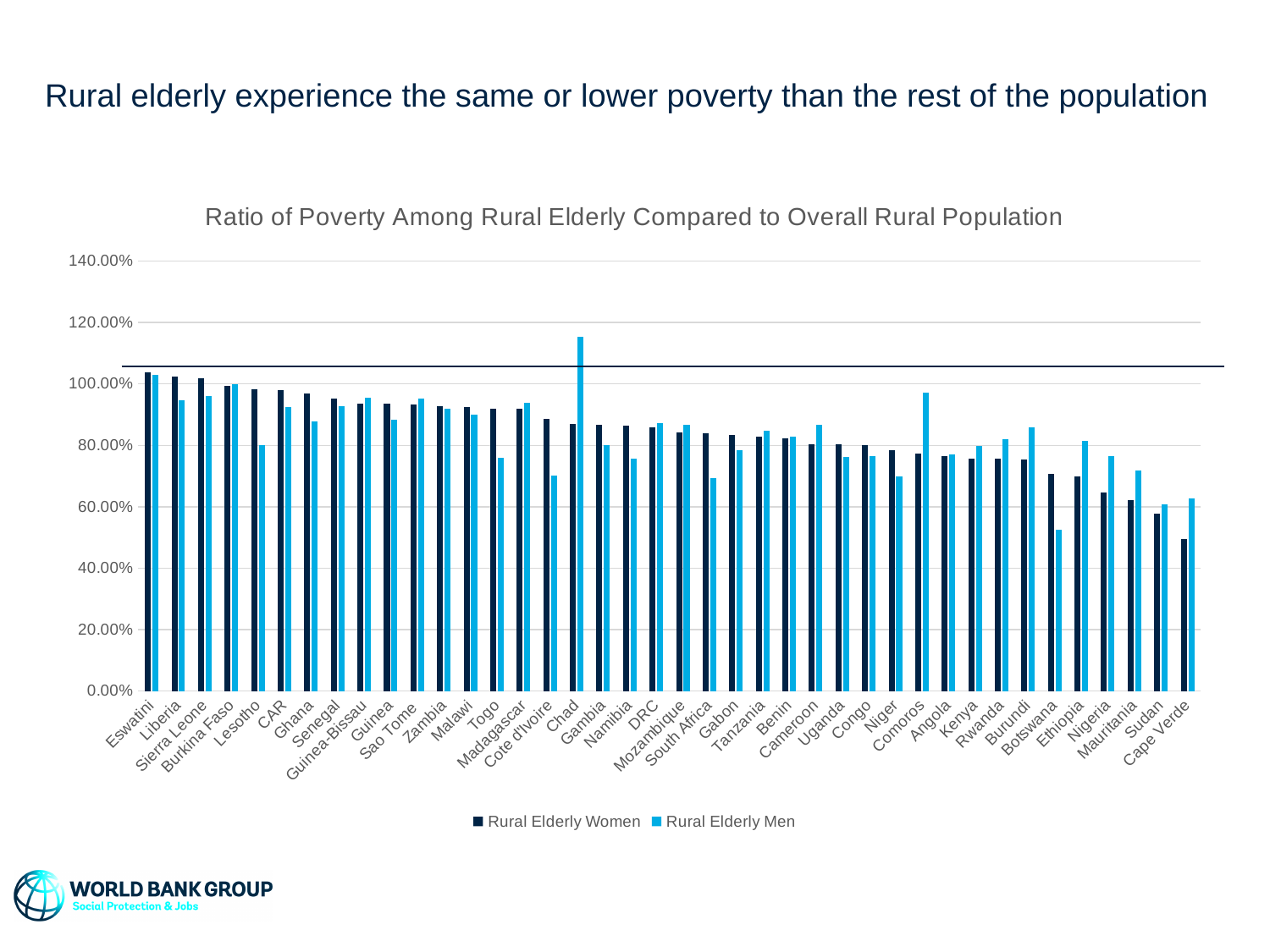
For Comoros, which series has the larger value, Rural Elderly Women or Rural Elderly Men? Rural Elderly Men Do the Rural Elderly Women values generally rise or fall from left to right along the x axis? fall How many series does the legend list? 2 How many countries are shown on the x axis? 40 Which country has the lowest value for Rural Elderly Men? Botswana Is the Rural Elderly Men value for Lesotho greater or less than 100.00%? less Is the Rural Elderly Women value for Cape Verde greater or less than 60.00%? less Which country has the lowest value for Rural Elderly Women? Cape Verde For Botswana, which series has the larger value, Rural Elderly Women or Rural Elderly Men? Rural Elderly Women What kind of chart is shown on the slide? bar chart Is the Rural Elderly Men value for Chad greater or less than 100.00%? greater Which country has the highest value for Rural Elderly Men? Chad